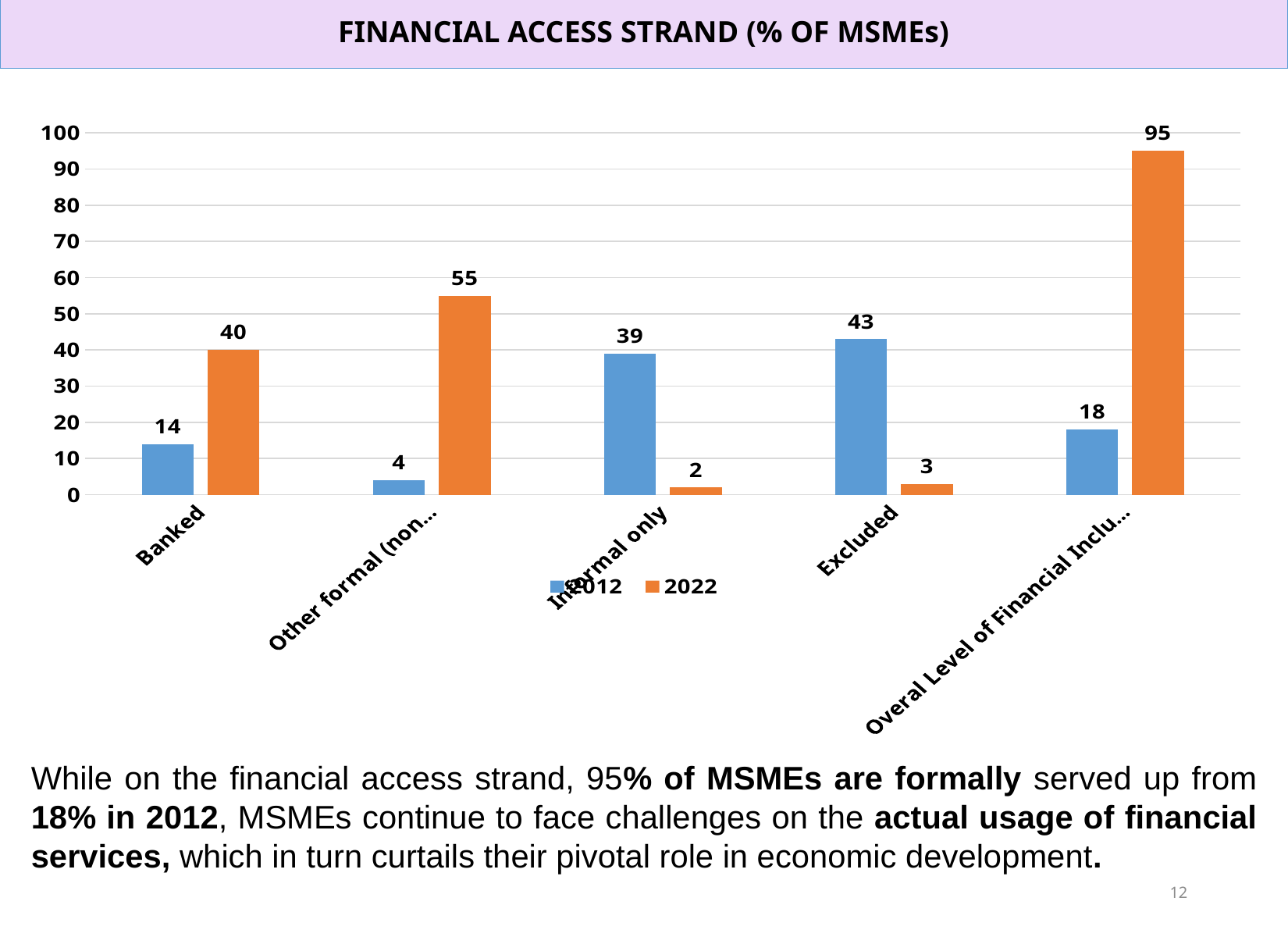
What is the 2022 value for Banked? 40 What is the 2012 value for Excluded? 43 Which category has the lowest 2012 value? Other formal (non…) How many categories are shown on the x axis? 5 What is the 2022 value for Informal only? 2 Which is larger for Excluded, the 2012 value or the 2022 value? 2012 How many series does the legend list? 2 What is the difference between the 2022 and 2012 values for Banked? 26 What type of chart is shown on the slide? Bar chart Which category has the highest 2022 value? Overal Level of Financial Inclu… What is the 2012 value for the Other formal (non…) category? 4 Which colour represents the 2022 series? Orange